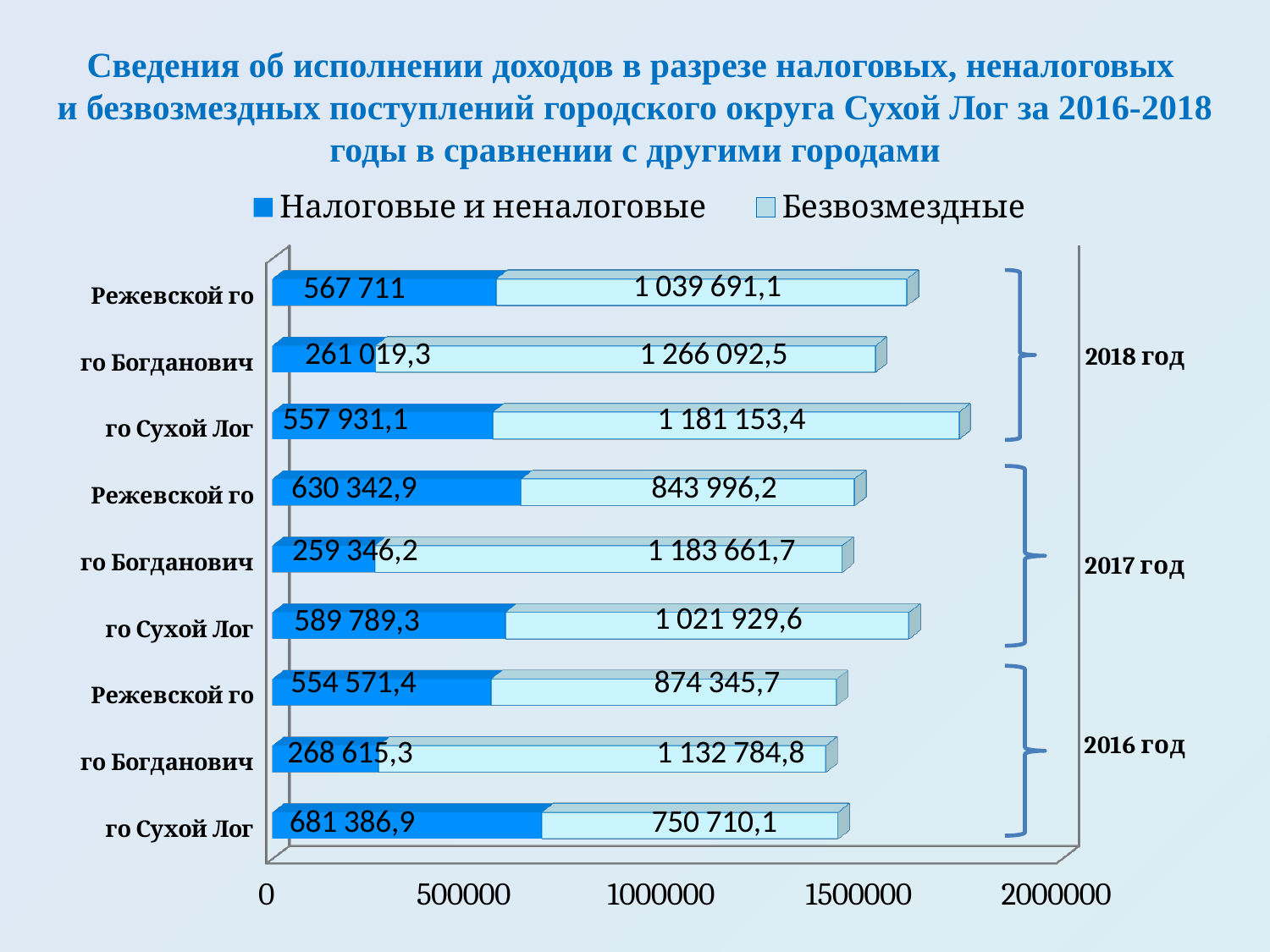
How many bars are plotted in the chart? 9 How many series does the legend list? 2 Which bar has the highest "Безвозмездные" value? го Богданович, 2018 год Which is larger for Режевской го in 2017 год: "Налоговые и неналоговые" or "Безвозмездные"? Безвозмездные What is the difference between "Безвозмездные" and "Налоговые и неналоговые" for го Сухой Лог in 2016 год? 69 323,2 What is the value of "Безвозмездные" for го Богданович in 2017 год? 1 183 661,7 What is the value of "Безвозмездные" for Режевской го in 2016 год? 874 345,7 What is the value of "Налоговые и неналоговые" for го Сухой Лог in 2018 год? 557 931,1 What type of chart is shown on the slide? stacked bar chart Which bar has the lowest "Налоговые и неналоговые" value? го Богданович, 2017 год What is the total of the stacked bar for го Сухой Лог in 2018 год? 1 739 084,5 Which bar has the highest "Налоговые и неналоговые" value? го Сухой Лог, 2016 год